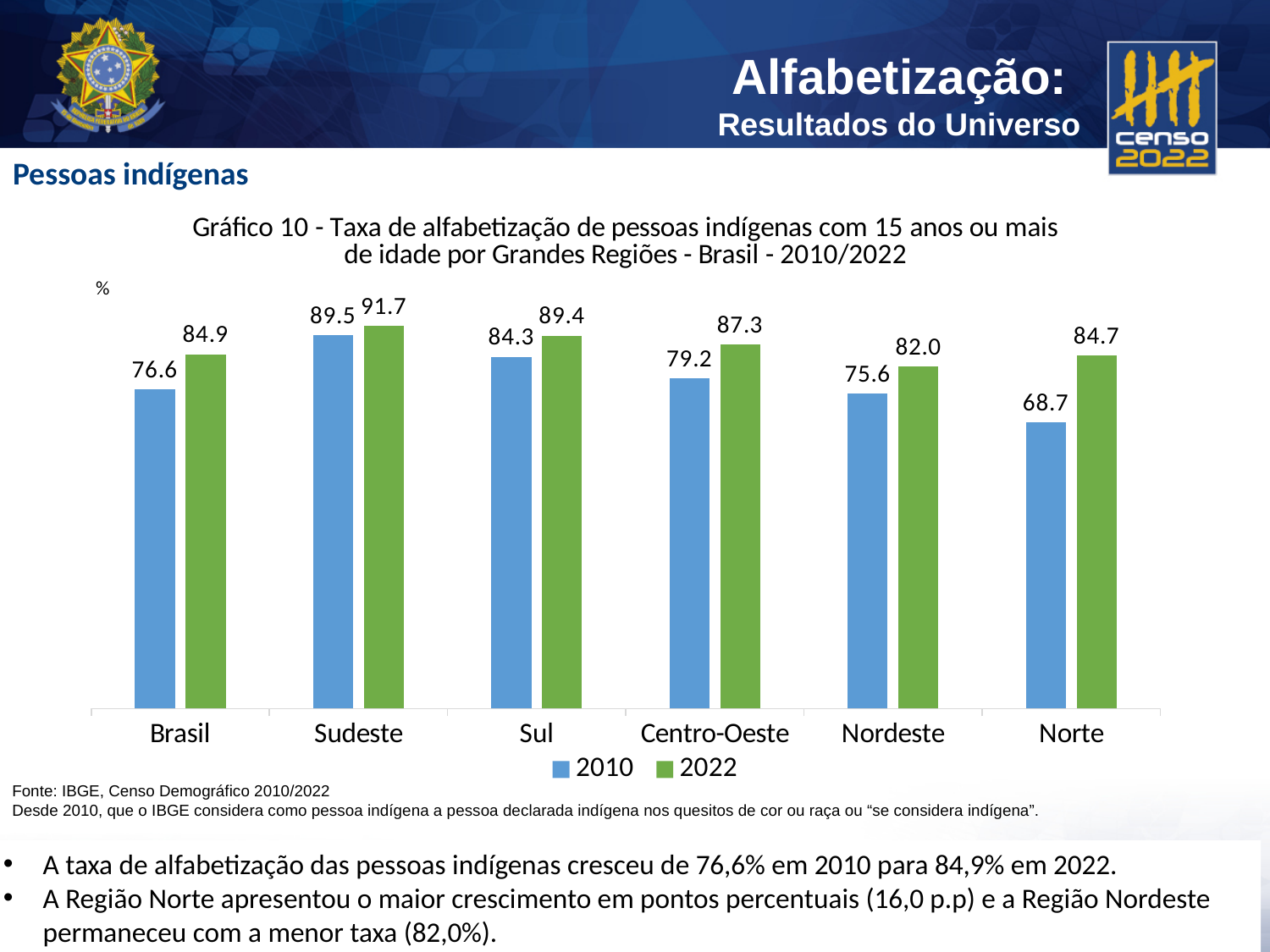
What kind of chart is this? Bar chart How many categories are shown on the x axis? 6 What is the 2010 literacy rate for Norte? 68.7 Which series is shown in green? 2022 What is the 2022 literacy rate for Sudeste? 91.7 How many series does the legend list? 2 What is the 2022 value for Centro-Oeste? 87.3 Which region has the highest 2022 literacy rate? Sudeste Which is larger: the 2022 value for Nordeste or the 2022 value for Norte? Norte What is the difference between the 2022 and 2010 values for Brasil? 8.3 Which category has the lowest 2010 value? Norte What is the difference between the 2022 and 2010 values for Norte? 16.0